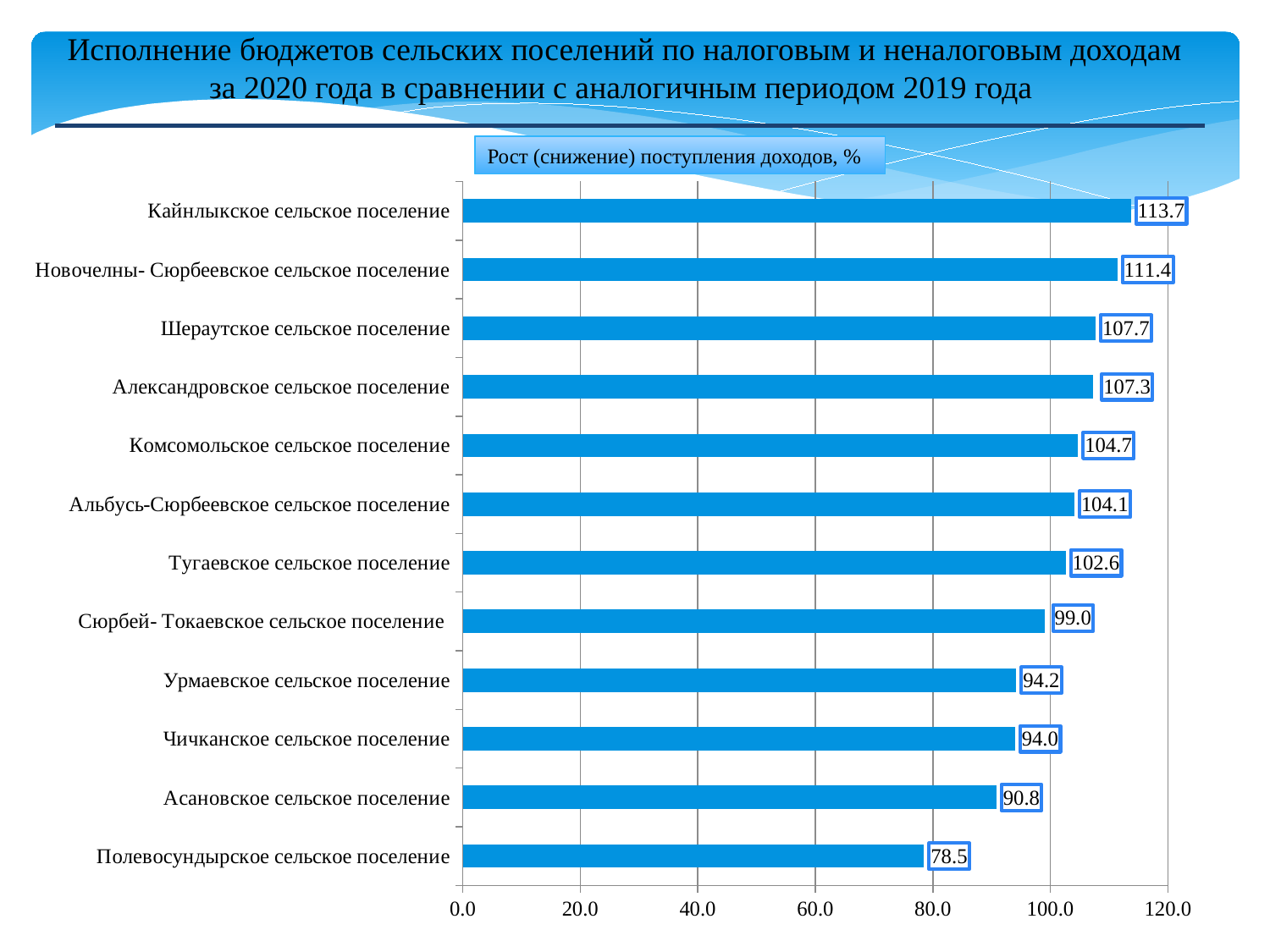
Is the value for Асановское сельское поселение greater or less than 100.0? less How many settlements are shown in the chart? 12 What is the difference between the values for Урмаевское сельское поселение and Чичканское сельское поселение? 0.2 What kind of chart is shown on the slide? bar chart What is the value for Полевосундырское сельское поселение? 78.5 What is the value for Тугаевское сельское поселение? 102.6 What is the value for Кайнлыкское сельское поселение? 113.7 What is the difference between the values for Кайнлыкское сельское поселение and Полевосундырское сельское поселение? 35.2 Which is larger, the value for Шераутское сельское поселение or Комсомольское сельское поселение? Шераутское сельское поселение What is the title of the chart? Рост (снижение) поступления доходов, % Which settlement has the highest value? Кайнлыкское сельское поселение Which settlement has the lowest value? Полевосундырское сельское поселение